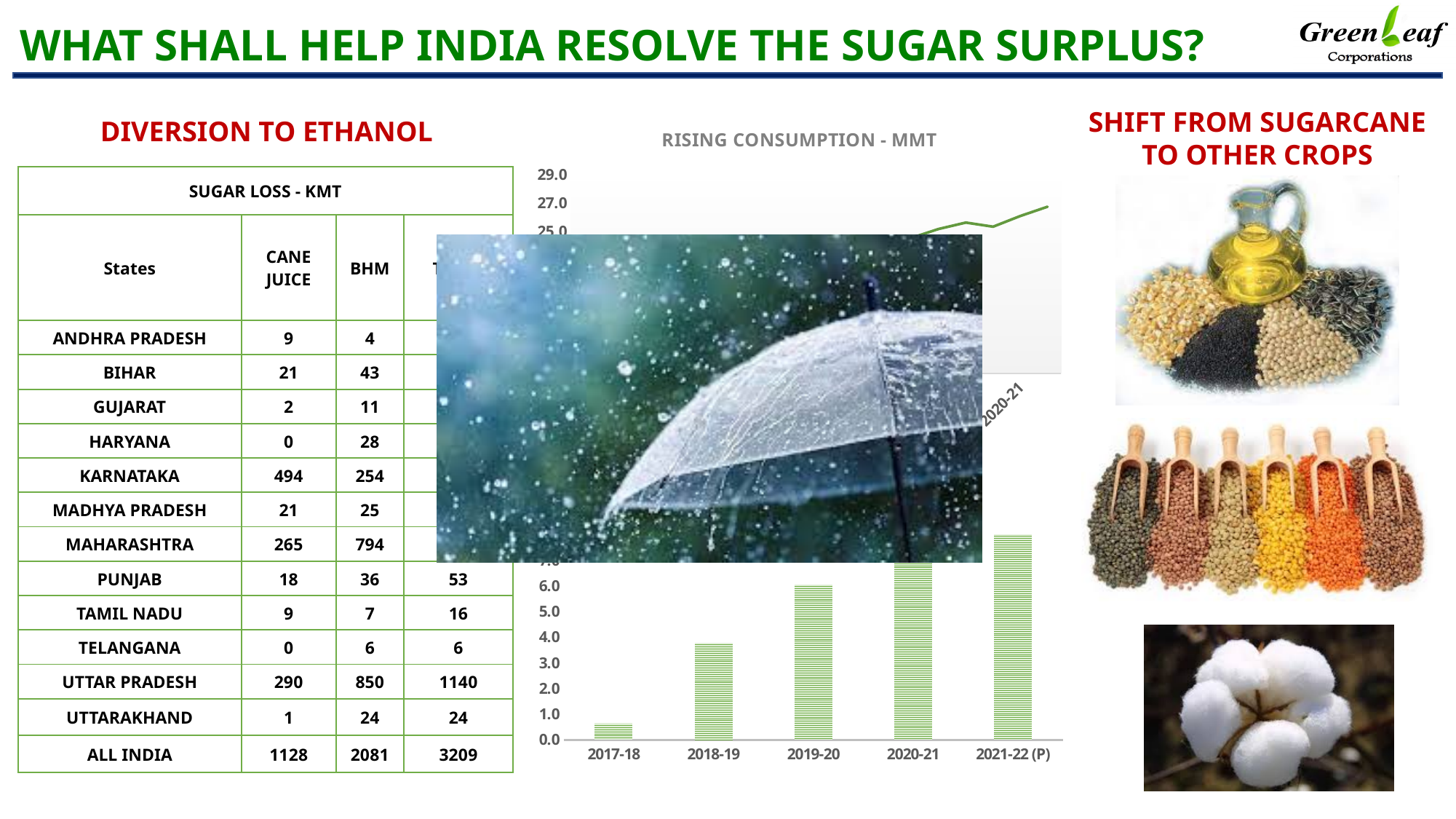
What is the title of the chart in the upper centre of the slide? RISING CONSUMPTION - MMT In the bottom bar chart, do the values rise or fall from 2017-18 to 2021-22 (P)? rise What kind of chart is the chart at the bottom centre of the slide with categories 2017-18 to 2021-22 (P)? bar chart In the bottom bar chart, which is larger, the value for 2019-20 or the value for 2018-19? 2019-20 In the bottom bar chart, is the value for 2021-22 (P) greater or less than 7.0? greater In the bottom bar chart, is the value for 2019-20 greater or less than 5.0? greater In the bottom bar chart, is the value for 2018-19 greater or less than 3.0? greater What kind of chart is the chart titled RISING CONSUMPTION - MMT? line chart In the bottom bar chart, which category has the lowest value? 2017-18 How many categories are shown on the x axis of the bottom bar chart? 5